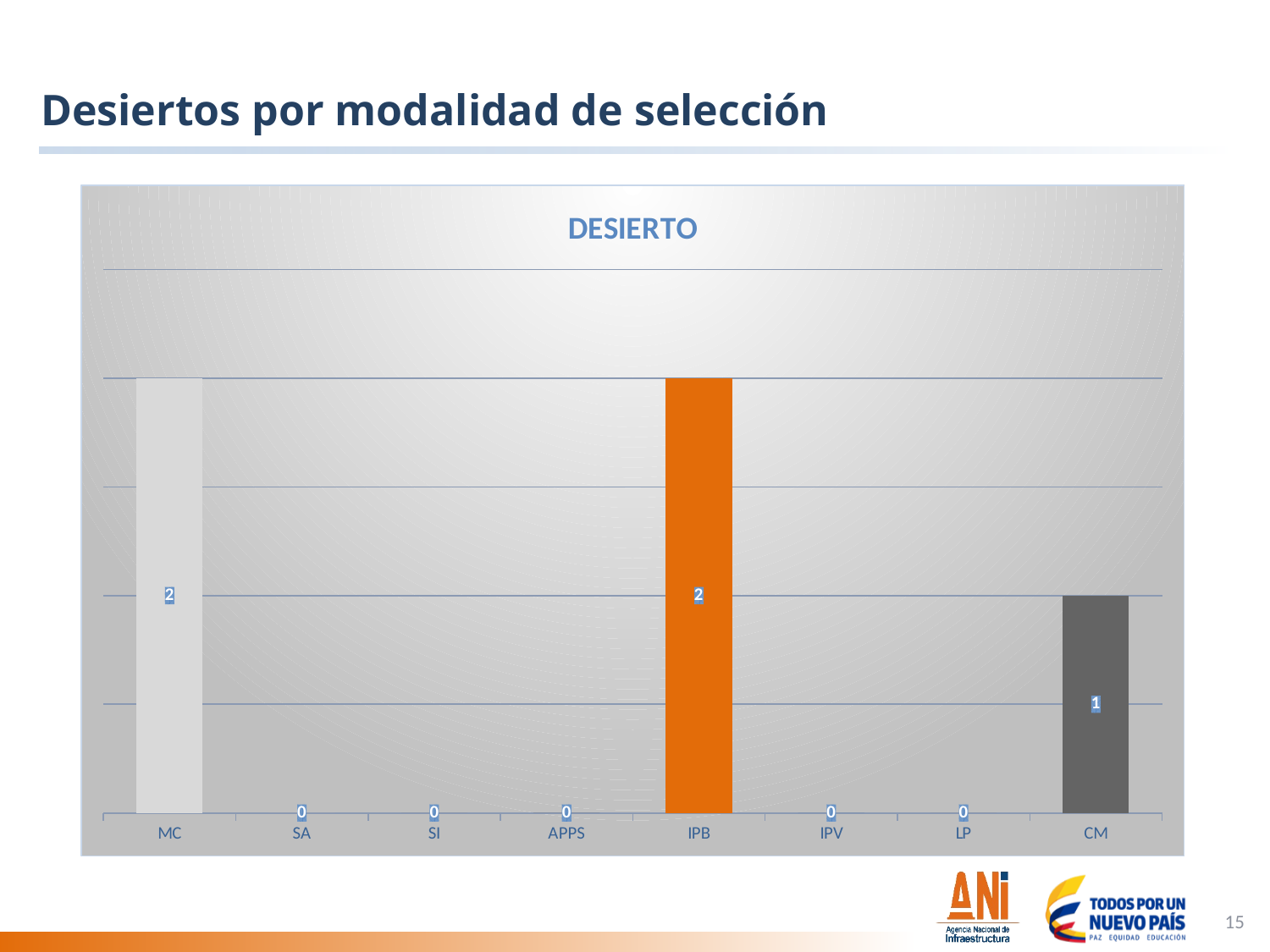
What is the value for SA? 0 How many categories are shown on the x axis? 8 Which is larger, the value for IPB or the value for CM? IPB What is the value for IPB? 2 What is the value for LP? 0 What is the title of the chart? DESIERTO What is the difference between the values for MC and CM? 1 What is the value for MC? 2 Which is larger, the value for CM or the value for IPV? CM What is the value for CM? 1 How many categories have a value of 0? 5 What kind of chart is this? Bar chart